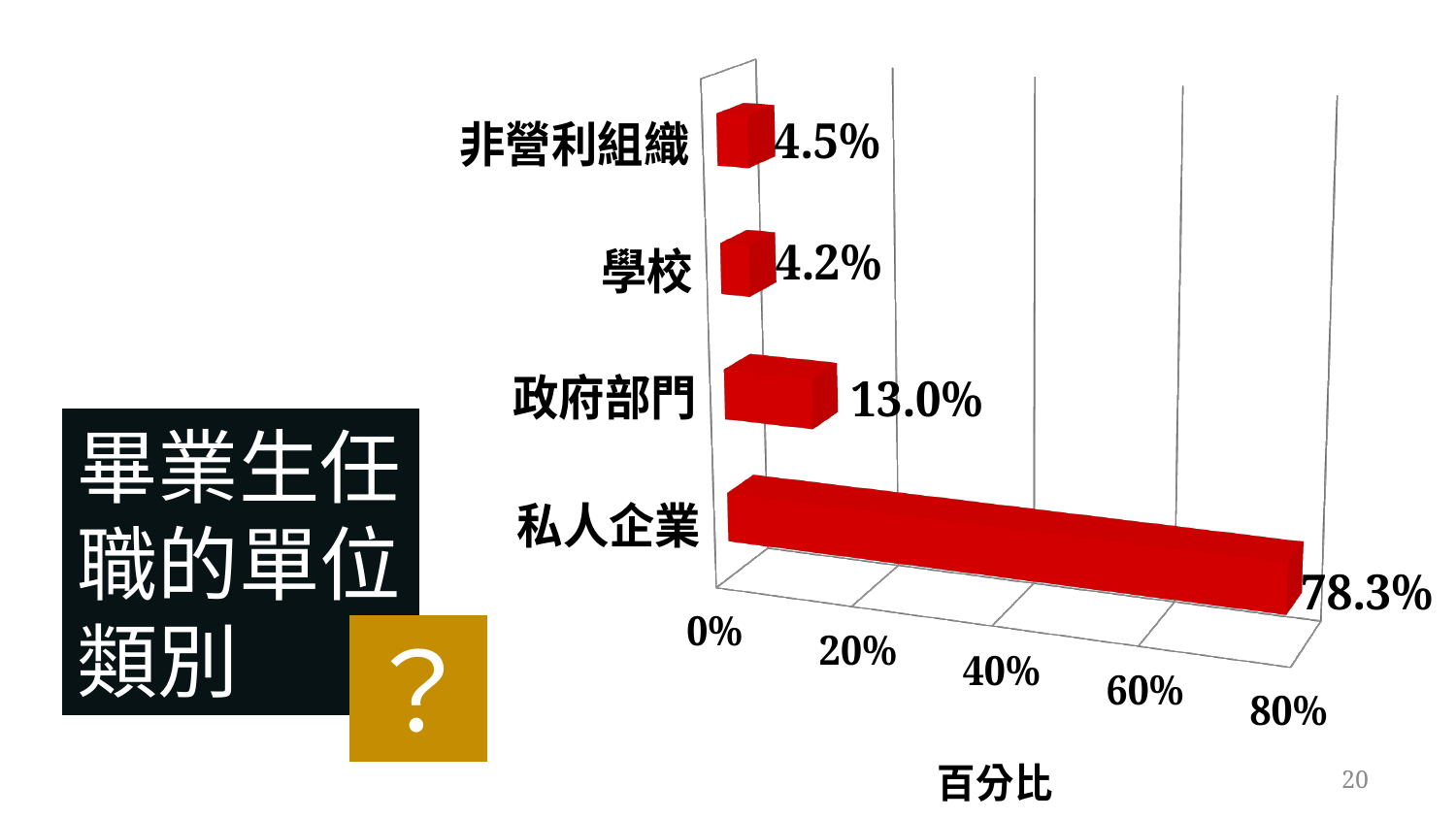
What is the difference between the values for 私人企業 and 政府部門? 65.3% How many categories are shown in the chart? 4 What is the value for 學校? 4.2% What is the difference between the values for 非營利組織 and 學校? 0.3% What is the value for 私人企業? 78.3% Which category has the lowest value? 學校 Which is larger, the value for 政府部門 or the value for 非營利組織? 政府部門 What is the value for 非營利組織? 4.5% What is the label of the horizontal axis? 百分比 What kind of chart is shown on the slide? bar chart Which category has the highest value? 私人企業 What is the value for 政府部門? 13.0%